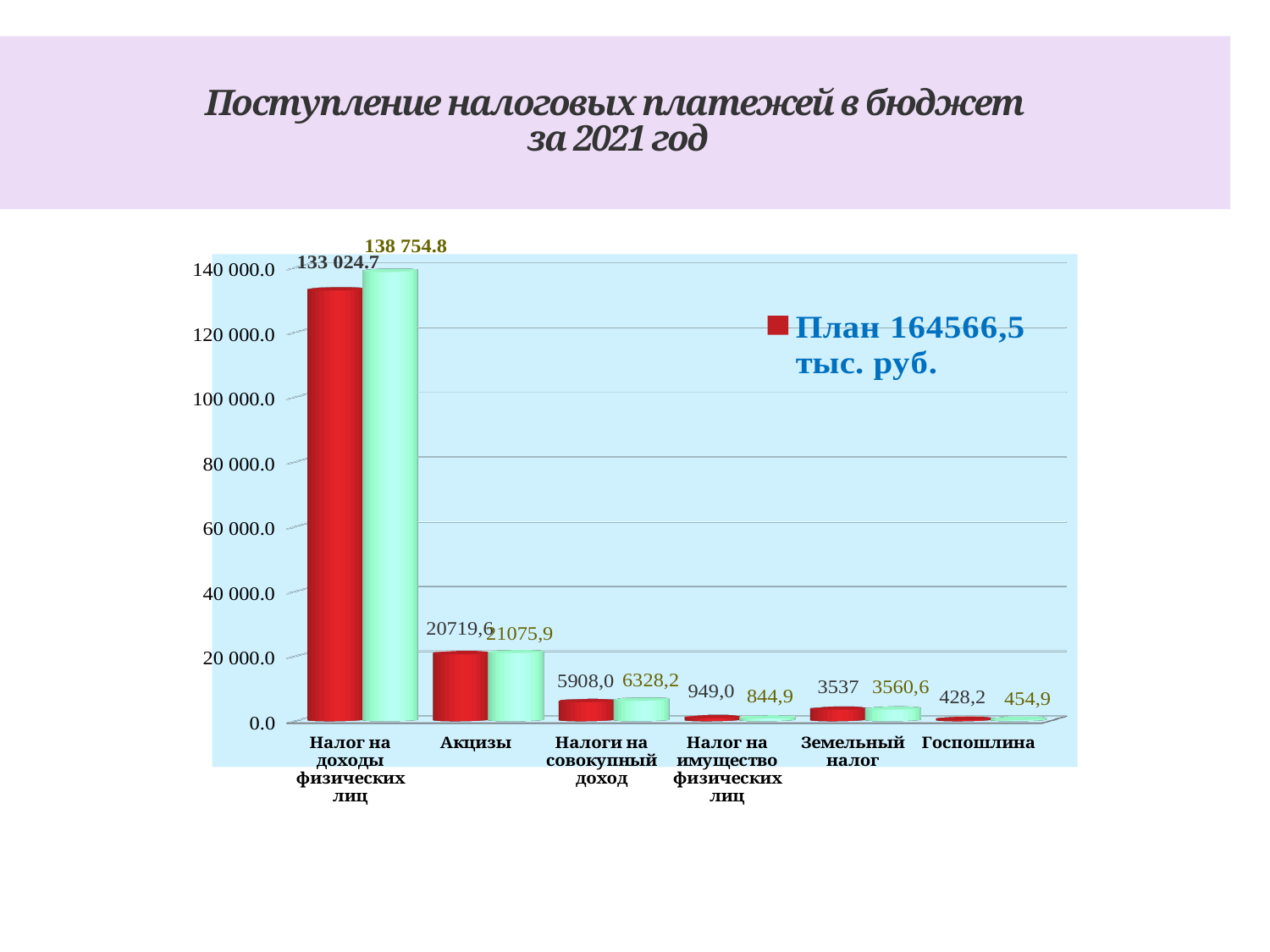
What is the value of the green bar for Госпошлина? 454,9 Which category has the highest red (План) bar? Налог на доходы физических лиц Is the red (План) bar for Налог на доходы физических лиц greater or less than 120 000.0? greater What is the value of the red (План) bar for Земельный налог? 3537 Which is larger for Налог на имущество физических лиц: the red (План) bar or the green bar? the red (План) bar Which category has the lowest green bar? Госпошлина What type of chart is shown on the slide? bar chart What is the value of the green bar for Налог на доходы физических лиц? 138 754.8 What is the value of the red (План) bar for Акцизы? 20719,6 How many categories are shown on the x axis of the chart? 6 What is the difference between the green bar and the red (План) bar for Налоги на совокупный доход? 420,2 What text does the legend entry on the chart show? План 164566,5 тыс. руб.